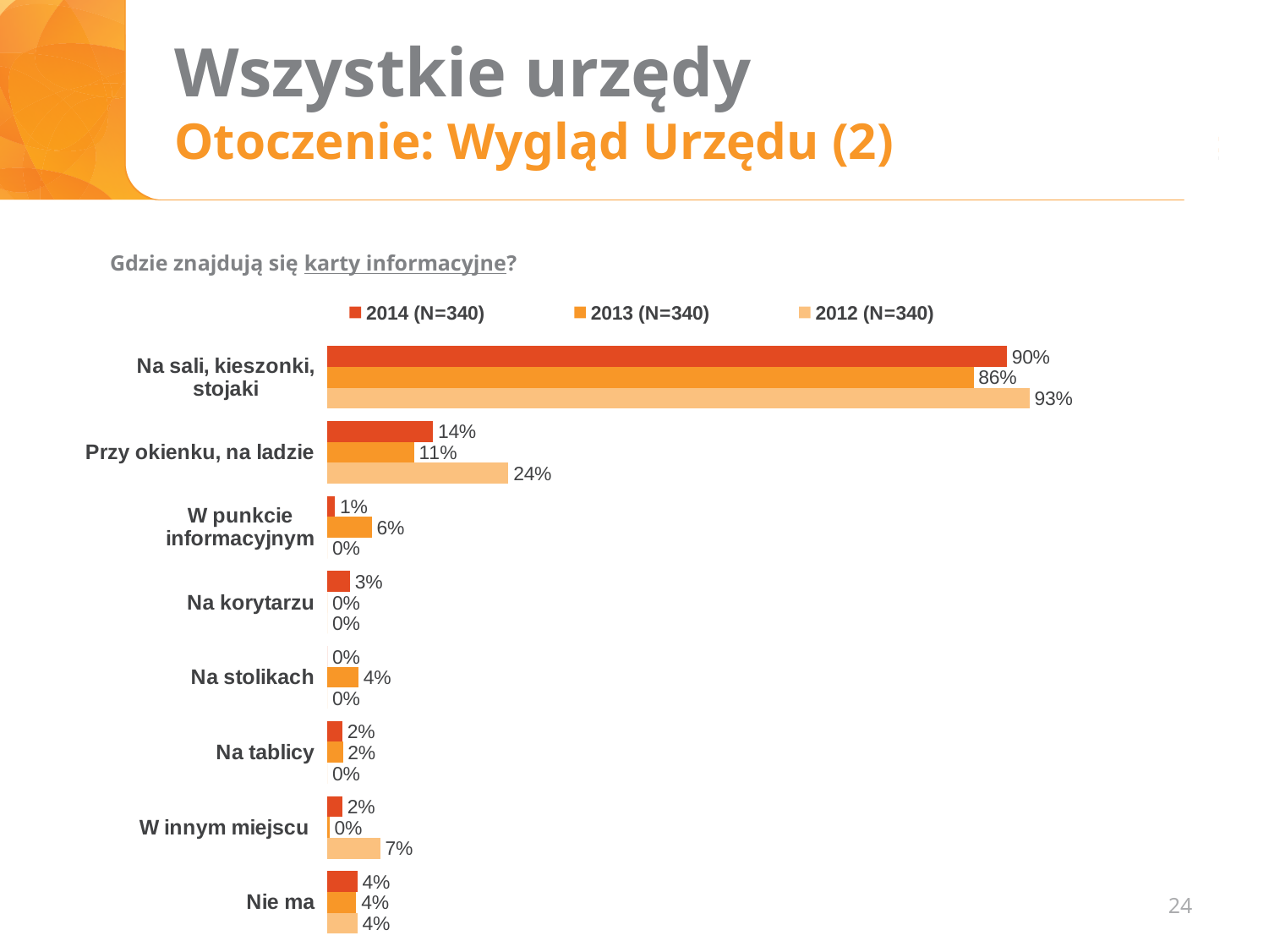
What question does the chart answer, as written above it? Gdzie znajdują się karty informacyjne? Which category has the highest value in the 2014 (N=340) series? Na sali, kieszonki, stojaki What is the value for "Na sali, kieszonki, stojaki" in the 2014 (N=340) series? 90% Which is larger for "Przy okienku, na ladzie": the 2014 (N=340) value or the 2013 (N=340) value? 2014 (N=340) How many categories are shown on the chart? 8 How many series does the legend list? 3 What kind of chart is shown on the slide? Bar chart What is the value for "W punkcie informacyjnym" in the 2013 (N=340) series? 6% What is the difference between the 2012 (N=340) and 2013 (N=340) values for "Przy okienku, na ladzie"? 13% What is the value for "Przy okienku, na ladzie" in the 2012 (N=340) series? 24% What is the value for "W innym miejscu" in the 2012 (N=340) series? 7% What is the difference between the 2012 (N=340) and 2014 (N=340) values for "Na sali, kieszonki, stojaki"? 3%